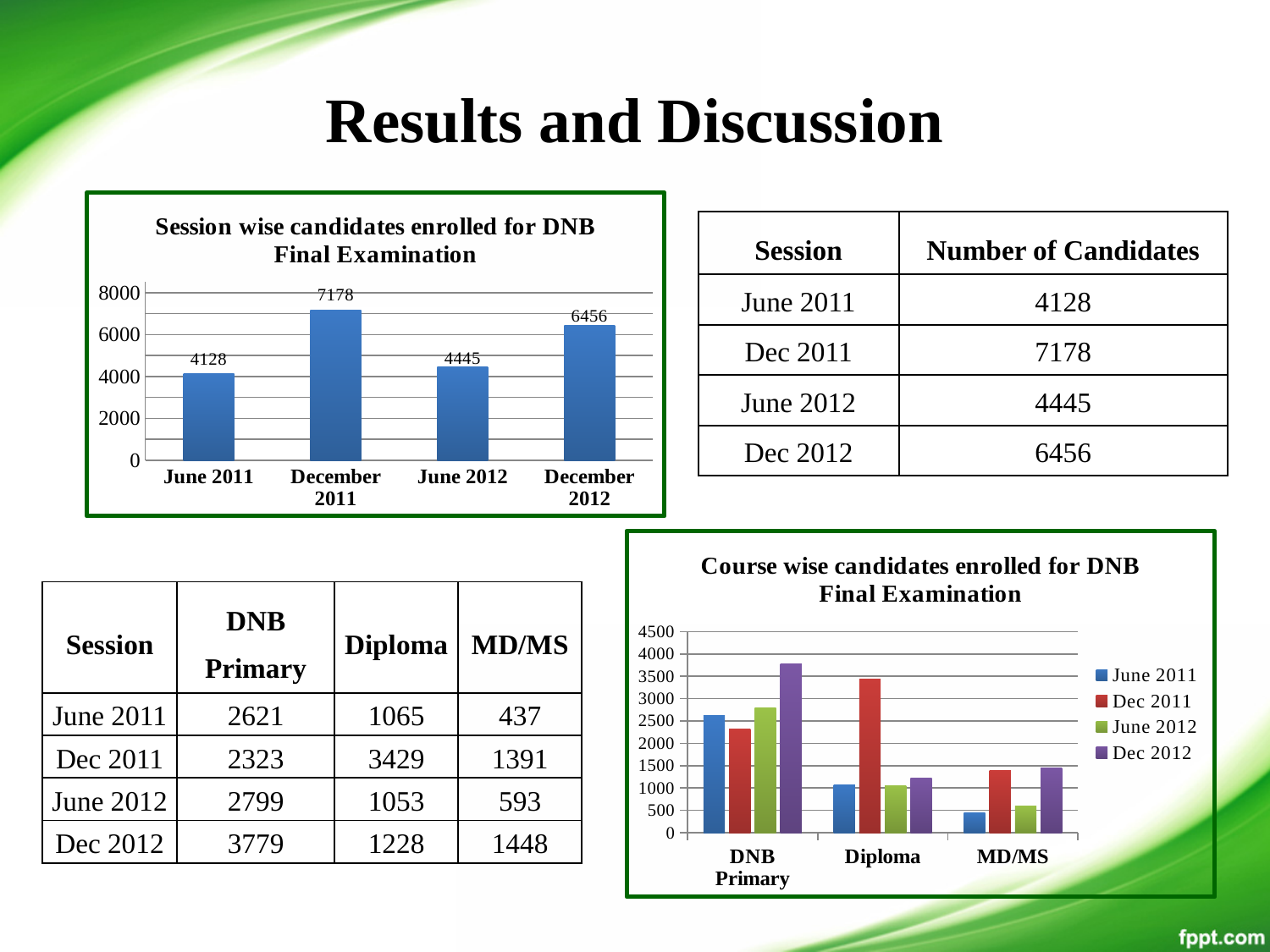
On the 'Session wise candidates enrolled for DNB Final Examination' chart, which session has the lowest number of candidates? June 2011 On the 'Session wise candidates enrolled for DNB Final Examination' chart, which session has the highest number of candidates? December 2011 On the 'Session wise candidates enrolled for DNB Final Examination' chart, what is the value for June 2012? 4445 On the 'Session wise candidates enrolled for DNB Final Examination' chart, what is the value for December 2011? 7178 On the 'Course wise candidates enrolled for DNB Final Examination' chart, how many series does the legend list? 4 On the 'Course wise candidates enrolled for DNB Final Examination' chart, which session has the tallest bar for Diploma? Dec 2011 On the 'Course wise candidates enrolled for DNB Final Examination' chart, is the Dec 2012 value for DNB Primary greater or less than 3500? greater On the 'Session wise candidates enrolled for DNB Final Examination' chart, how many sessions are shown on the x axis? 4 What type of chart is the 'Session wise candidates enrolled for DNB Final Examination' chart? Bar chart On the 'Session wise candidates enrolled for DNB Final Examination' chart, what is the difference between the December 2012 and June 2012 values? 2011 On the 'Course wise candidates enrolled for DNB Final Examination' chart, which is larger for MD/MS: the June 2012 value or the Dec 2012 value? Dec 2012